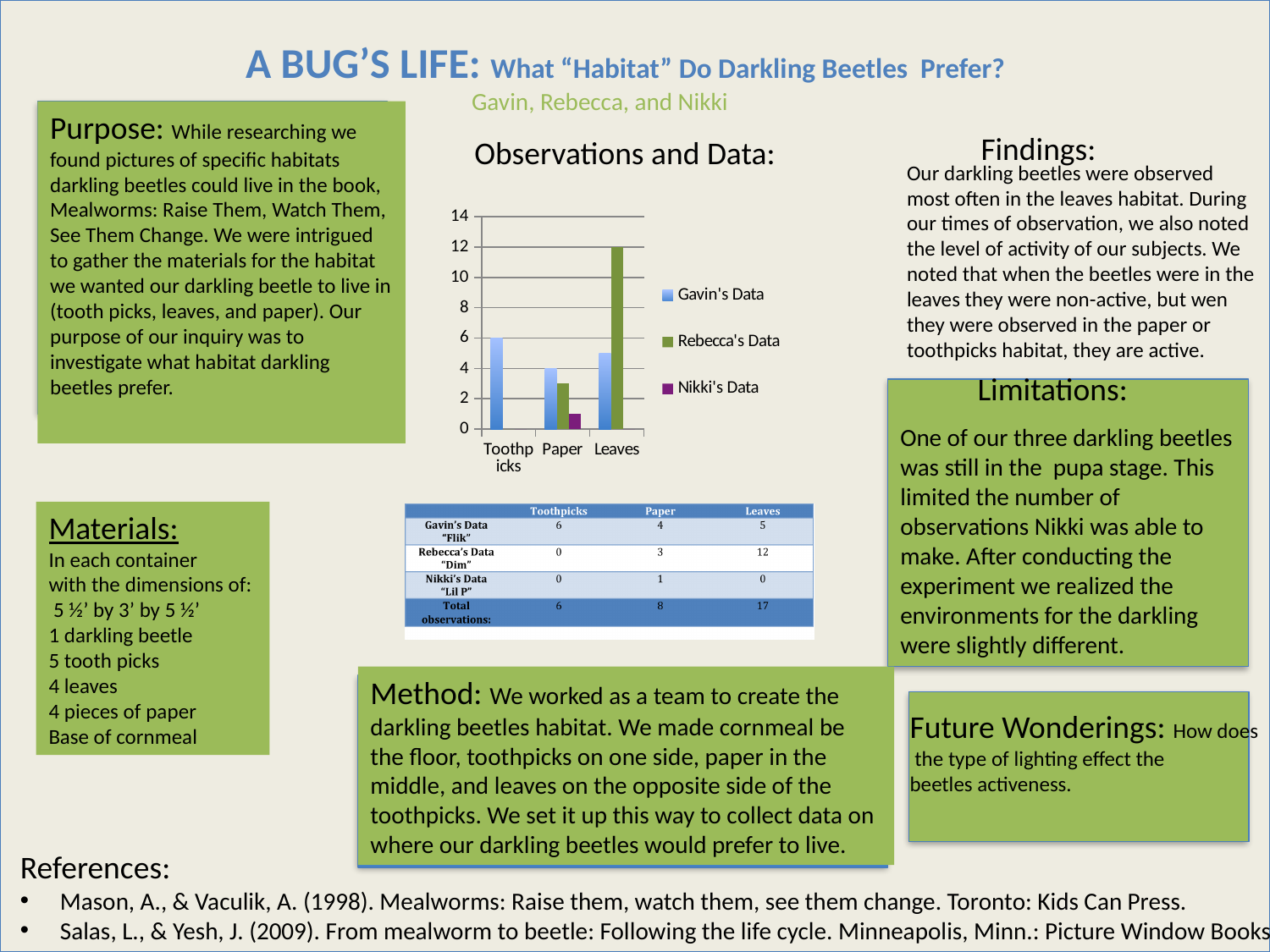
For which category is Rebecca's Data highest? Leaves Is the value of Rebecca's Data for Leaves greater or less than 10? greater What is the value of Gavin's Data for Paper? 4 Does Rebecca's Data rise or fall from Toothpicks to Leaves? rise Which series has the highest value for Toothpicks? Gavin's Data What is the value of Gavin's Data for Toothpicks? 6 How many habitat categories are shown on the x axis of the chart? 3 Which series has the lowest value for Paper? Nikki's Data What kind of chart is shown under Observations and Data? bar chart What is the value of Rebecca's Data for Leaves? 12 How many series does the chart legend list? 3 What is the difference between Rebecca's Data for Leaves and Gavin's Data for Toothpicks? 6